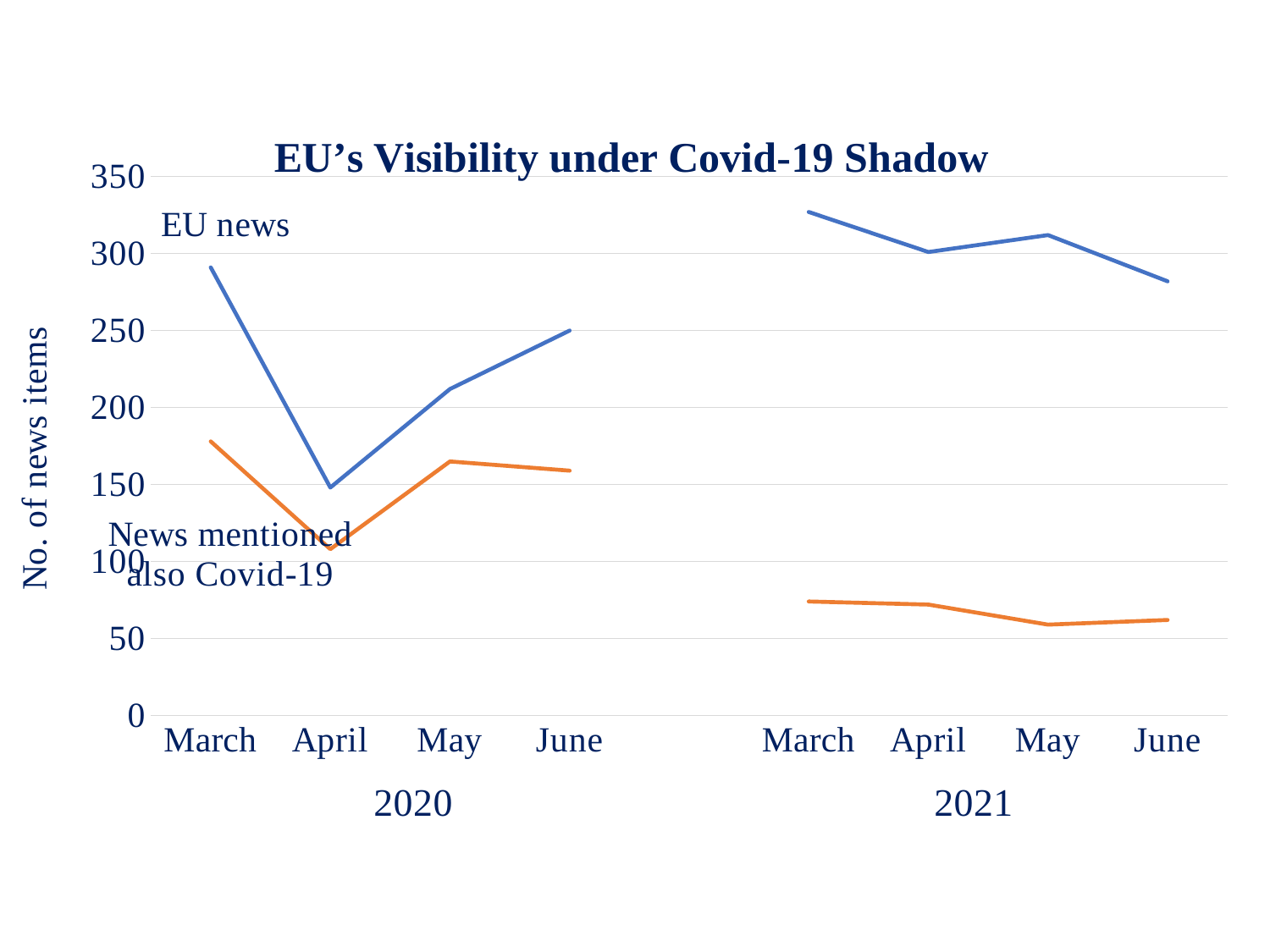
Is the value for EU news in April 2020 greater or less than 200? less What kind of chart is shown on the slide? line chart How many data series are plotted in the chart? 2 In which month and year does the EU news series reach its highest value? March 2021 In which month and year does the EU news series reach its lowest value? April 2020 Is the value for News mentioned also Covid-19 in May 2021 greater or less than 100? less Is the value for News mentioned also Covid-19 in March 2020 greater or less than 150? greater Which is larger for News mentioned also Covid-19: the value in March 2020 or the value in March 2021? March 2020 What is the title of the chart? EU's Visibility under Covid-19 Shadow How many months are plotted along the x axis in total across both years? 8 What is the label of the vertical axis? No. of news items